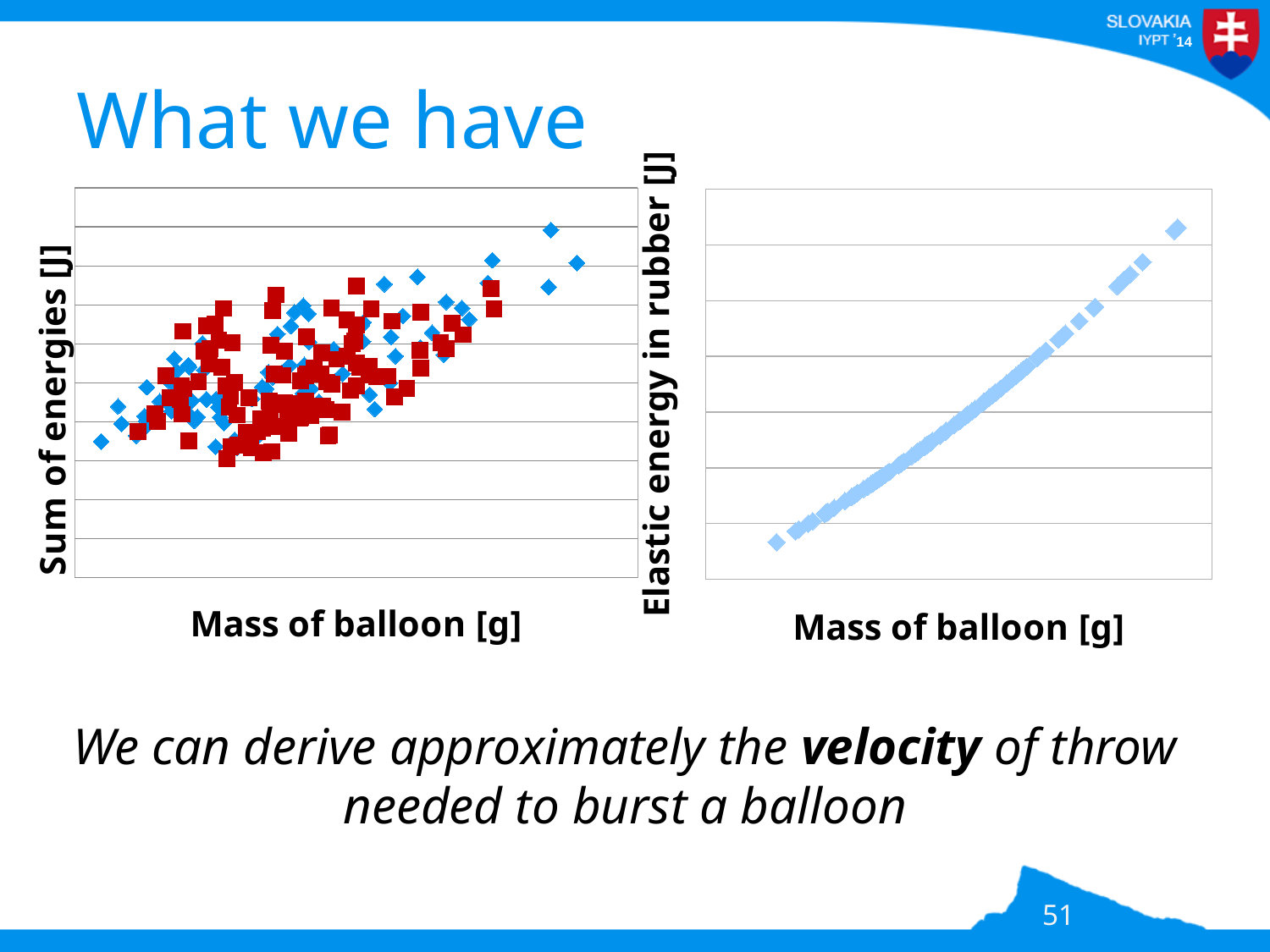
What kind of chart is the right chart on the slide? Scatter chart What kind of chart is the left chart on the slide? Scatter chart What is the label of the y axis on the left chart? Sum of energies [J] In the right chart, do the values of elastic energy in rubber rise or fall as the mass of balloon increases? Rise What is the label of the y axis on the right chart? Elastic energy in rubber [J] In the left chart, do the values of sum of energies generally rise or fall as the mass of balloon increases? Rise